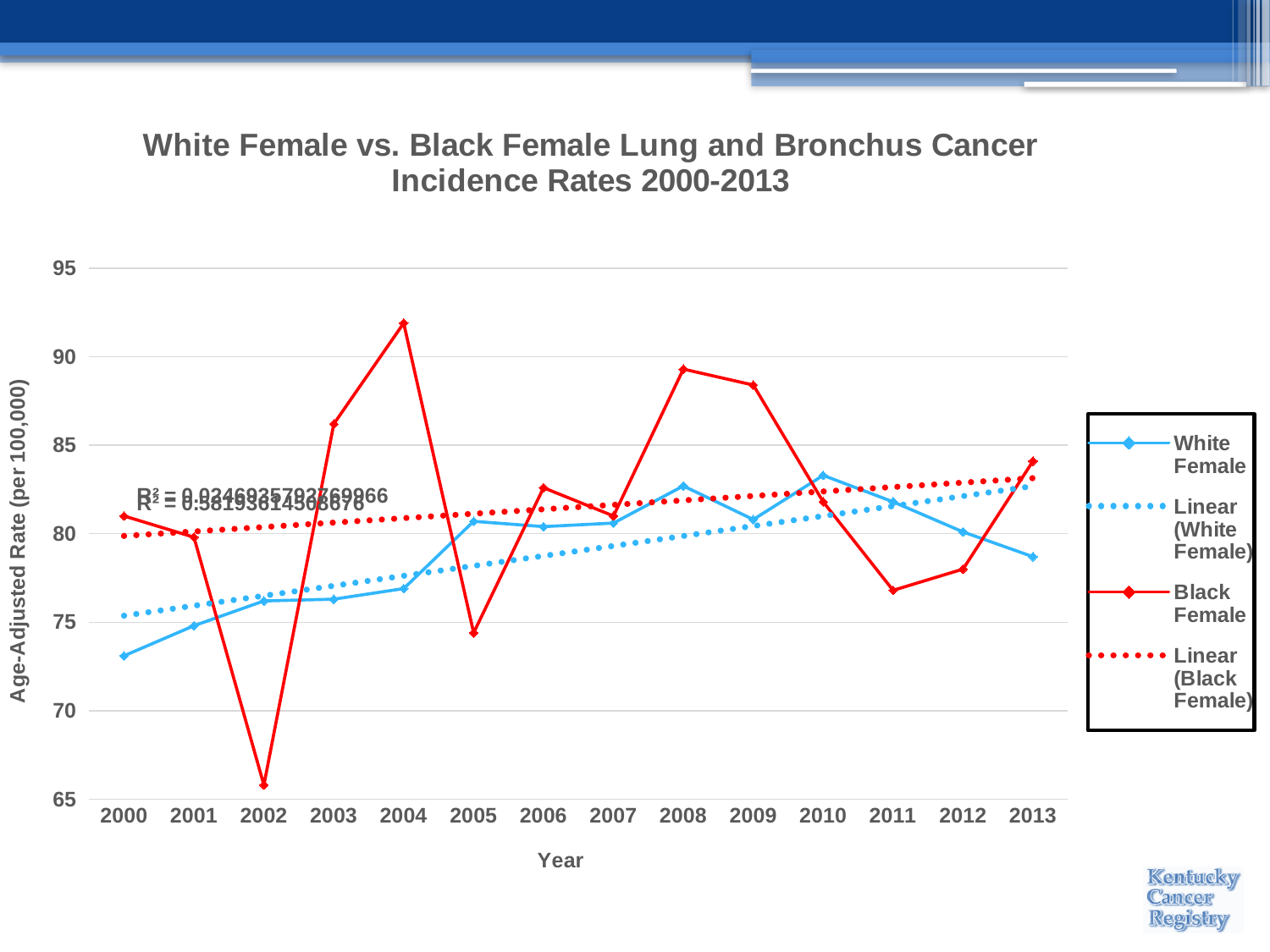
How many years are plotted along the x axis? 14 In which year does the Black Female series reach its lowest value? 2002 In which year does the White Female series reach its lowest value? 2000 Is the White Female value for 2000 greater or less than 75? less What kind of chart is shown on the slide? line chart What is the title of the chart? White Female vs. Black Female Lung and Bronchus Cancer Incidence Rates 2000-2013 In which year does the Black Female series reach its highest value? 2004 Is the Black Female value for 2002 greater or less than 70? less How many entries does the legend list? 4 In 2011, which series has the higher value, White Female or Black Female? White Female In 2008, which series has the higher value, White Female or Black Female? Black Female Is the Black Female value for 2004 greater or less than 90? greater